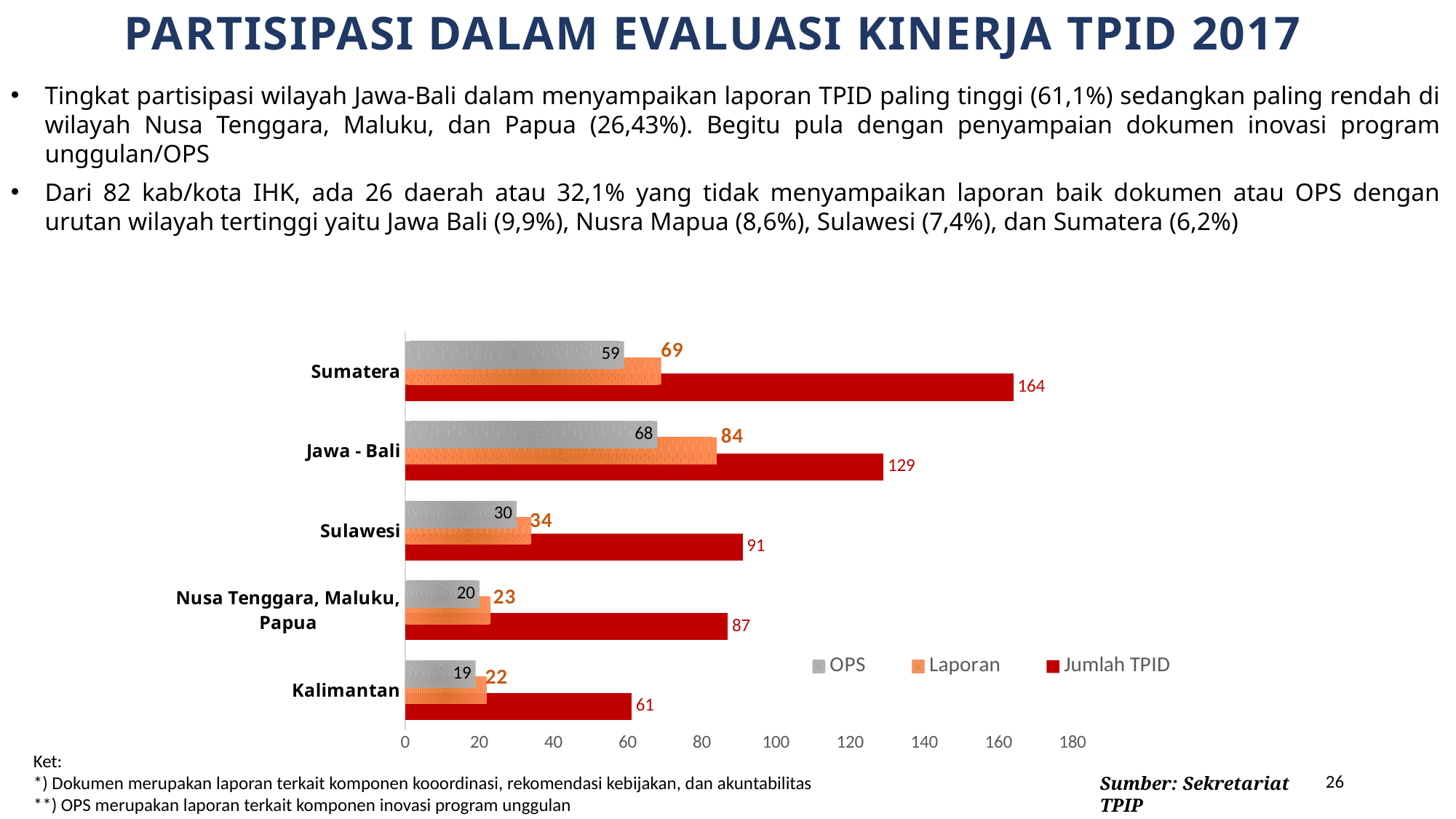
Which is larger, the OPS value for Jawa - Bali or the OPS value for Sumatera? Jawa - Bali What is the Jumlah TPID value for Sumatera? 164 What is the Laporan value for Nusa Tenggara, Maluku, Papua? 23 What is the difference between the Jumlah TPID values for Sumatera and Jawa - Bali? 35 What is the OPS value for Sulawesi? 30 How many series does the legend list? 3 How many regions are shown on the chart? 5 Which region has the highest Jumlah TPID value? Sumatera Which region has the lowest OPS value? Kalimantan What kind of chart is shown on the slide? Bar chart Which series is shown in dark red on the chart? Jumlah TPID What is the Laporan value for Jawa - Bali? 84